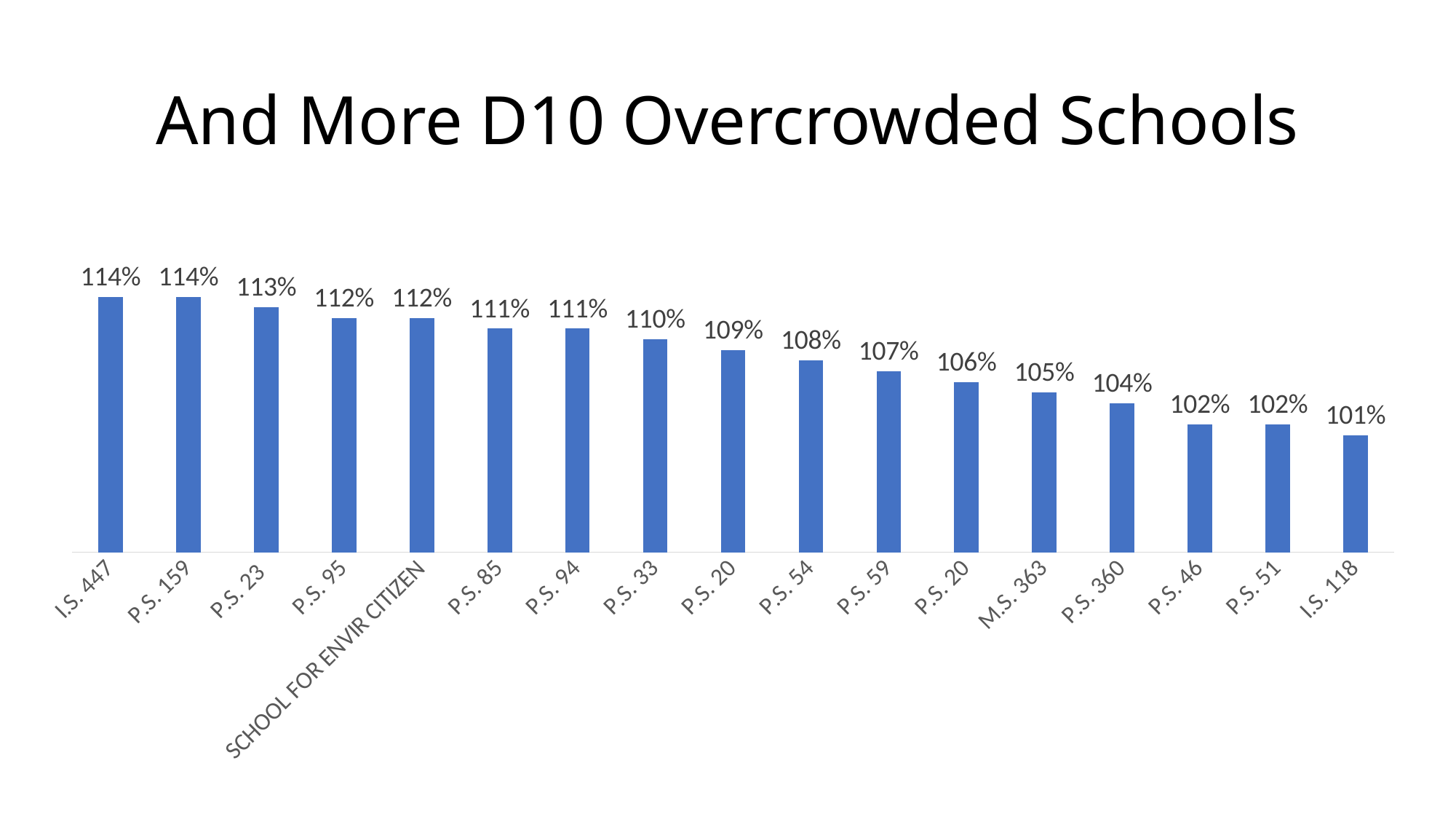
What is the value for SCHOOL FOR ENVIR CITIZEN? 112% What is the value for P.S. 360? 104% Which is larger, the value for P.S. 54 or the value for P.S. 59? P.S. 54 How many schools are shown in the chart? 17 Which school has the lowest value? I.S. 118 Do the values rise or fall from left to right along the x axis? Fall What is the difference between the values for P.S. 33 and P.S. 46? 8% What is the value for P.S. 23? 113% What is the value for I.S. 447? 114% What is the value for M.S. 363? 105% What is the difference between the values for I.S. 447 and I.S. 118? 13% What kind of chart is shown on the slide? Bar chart